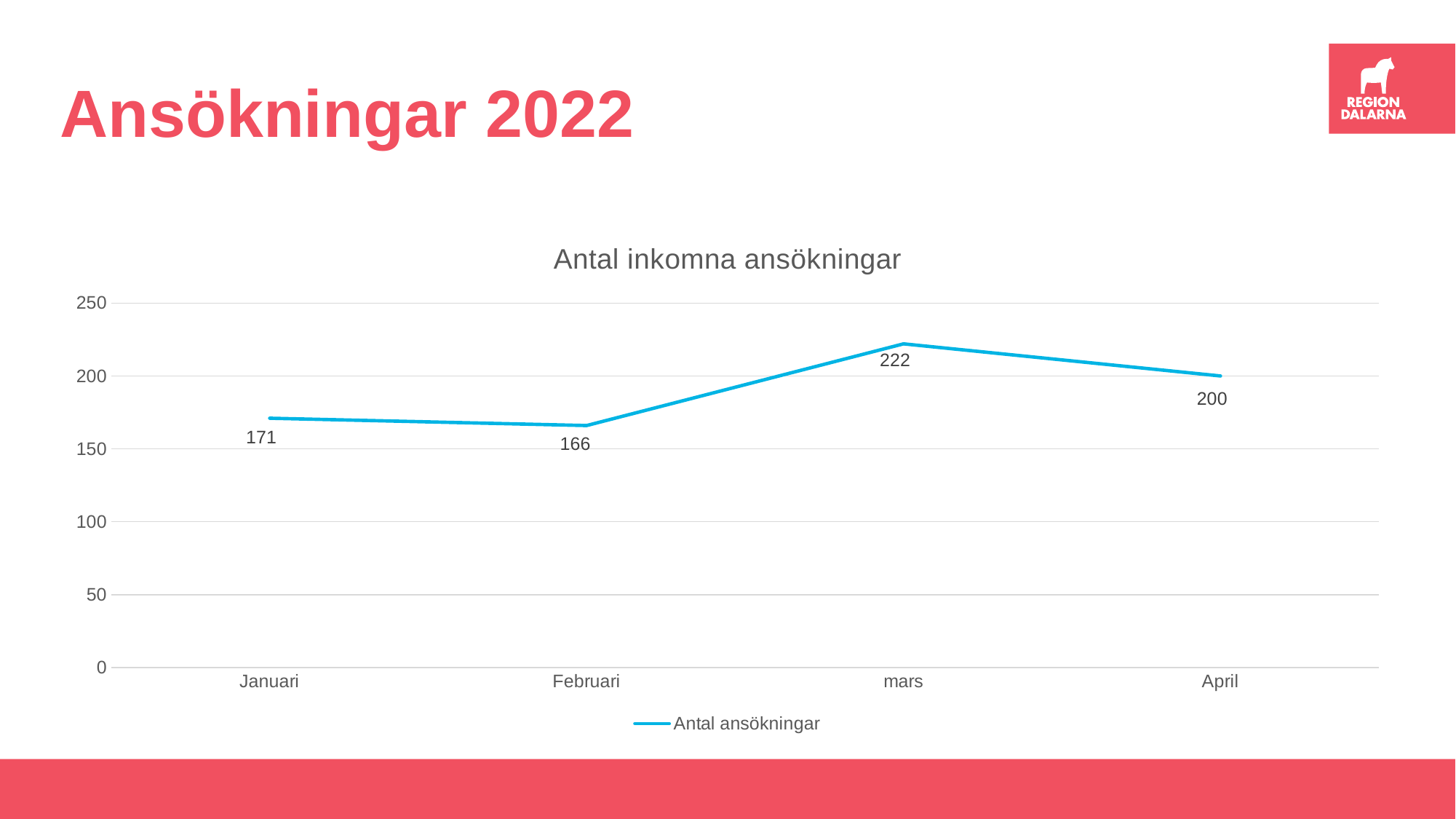
Which is larger, the value for Januari or the value for April? April What is the title of the chart? Antal inkomna ansökningar What is the value for Februari? 166 What is the difference between the values for mars and Februari? 56 What kind of chart is this? line chart Is the value for mars greater or less than 200? greater What is the value for Januari? 171 What is the value for April? 200 Which month has the highest number of applications? mars Which month has the lowest number of applications? Februari What is the value for mars? 222 How many months are shown on the x axis? 4